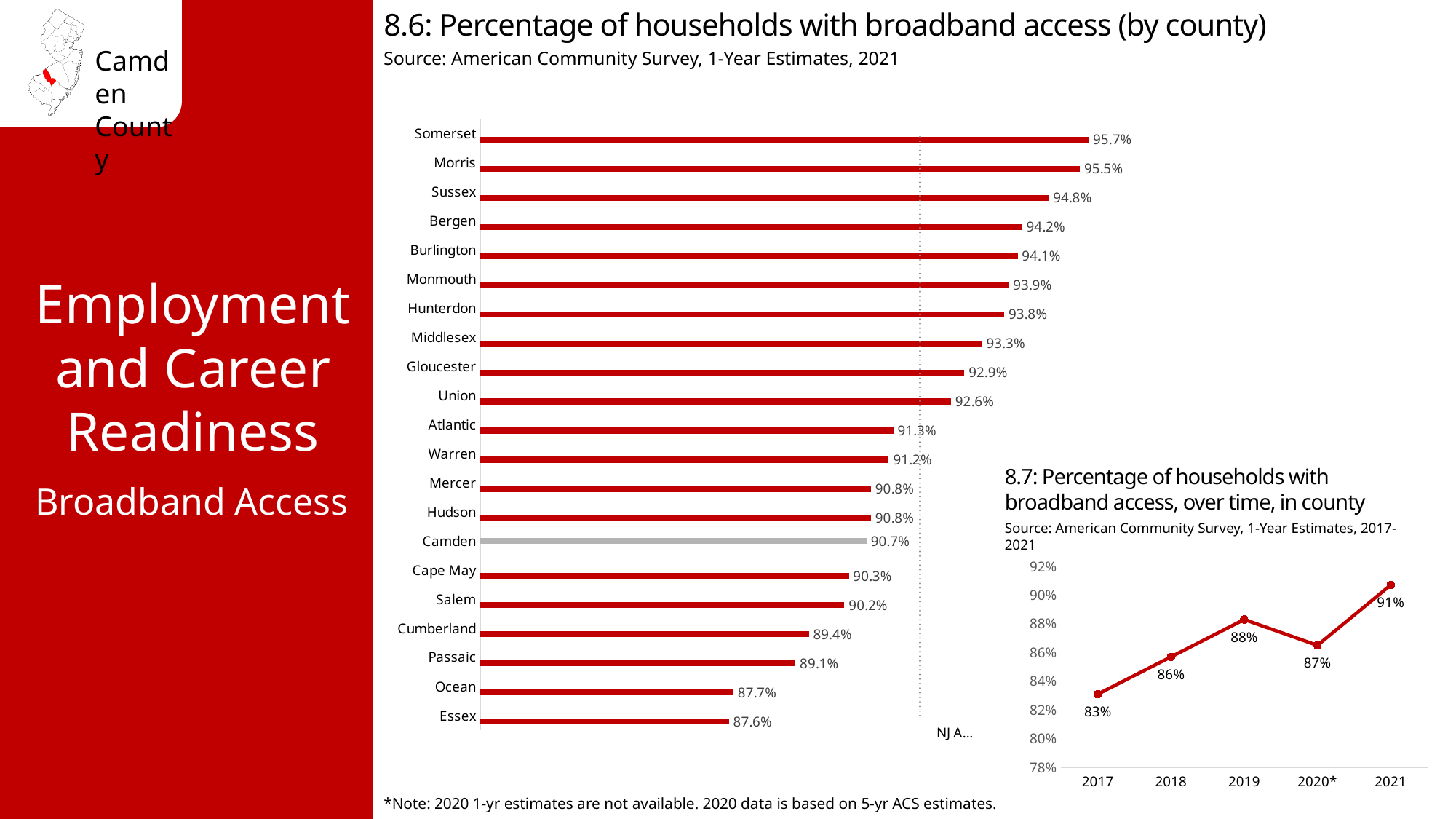
In chart 8.6 (Percentage of households with broadband access by county), what is the value for Camden? 90.7% In chart 8.7 (broadband access over time in county), which year has the lowest value? 2017 In chart 8.6 (by county), what is the difference between Somerset and Essex? 8.1% What kind of chart is chart 8.6 (Percentage of households with broadband access by county)? Bar chart In chart 8.6 (by county), which has a higher value, Bergen or Burlington? Bergen In chart 8.7 (broadband access over time in county), what is the difference between 2021 and 2017? 8% In chart 8.6 (by county), which county has the lowest percentage of households with broadband access? Essex In chart 8.7 (broadband access over time in county), what is the value for 2019? 88% In chart 8.6 (by county), what is the value for Gloucester? 92.9% In chart 8.6 (by county), which county has the highest percentage of households with broadband access? Somerset In chart 8.6 (by county), which bar is shown in grey instead of red? Camden In chart 8.6 (by county), how many counties are shown? 21